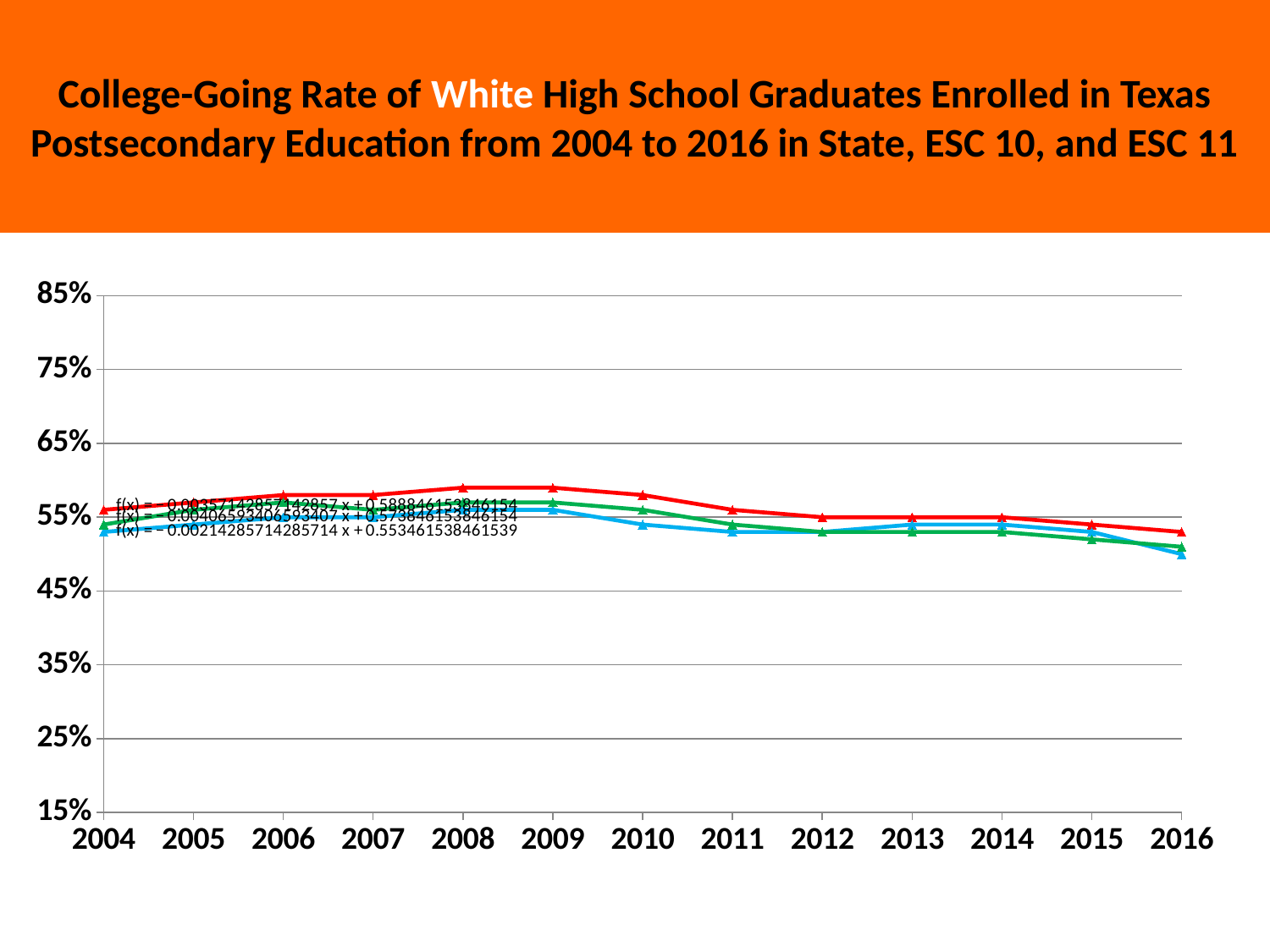
How many lines (data series) are plotted on the chart? 3 What is the first year shown on the x axis? 2004 What kind of chart is shown on the slide? line chart Overall, do the lines rise or fall from 2004 to 2016? fall In 2010, which line has the higher value, the red line or the blue line? the red line Is the value of the green line in 2008 greater or less than 65%? less In which year does the blue line reach its lowest value? 2016 Is the value of the red line in 2009 greater or less than 55%? greater Is the value of the red line in 2016 greater or less than 55%? less How many years are plotted along the x axis? 13 What is the highest value labelled on the y axis? 85%